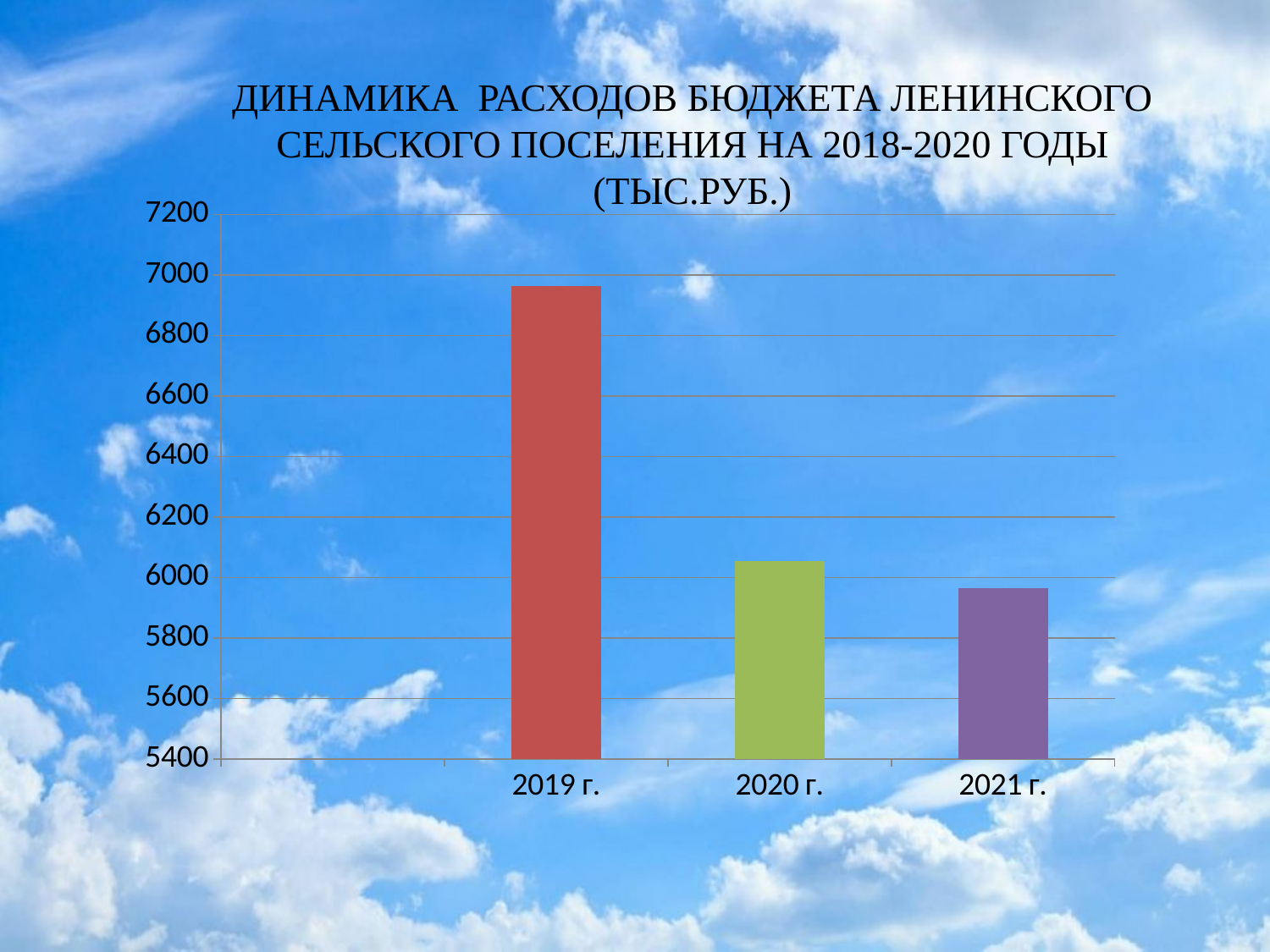
What colour is the bar for 2019 г.? red Do the values rise or fall from 2019 г. to 2021 г.? fall What is the unit of measurement stated in the chart title? ТЫС.РУБ. How many bars (years) are plotted in the chart? 3 Which is larger, the value for 2019 г. or the value for 2020 г.? 2019 г. Is the value for 2020 г. greater or less than 6000? greater Is the value for 2021 г. greater or less than 6000? less Is the value for 2019 г. greater or less than 7000? less Which year has the highest budget expenditure in the chart? 2019 г. What kind of chart is shown on the slide? bar chart Which year has the lowest budget expenditure in the chart? 2021 г.